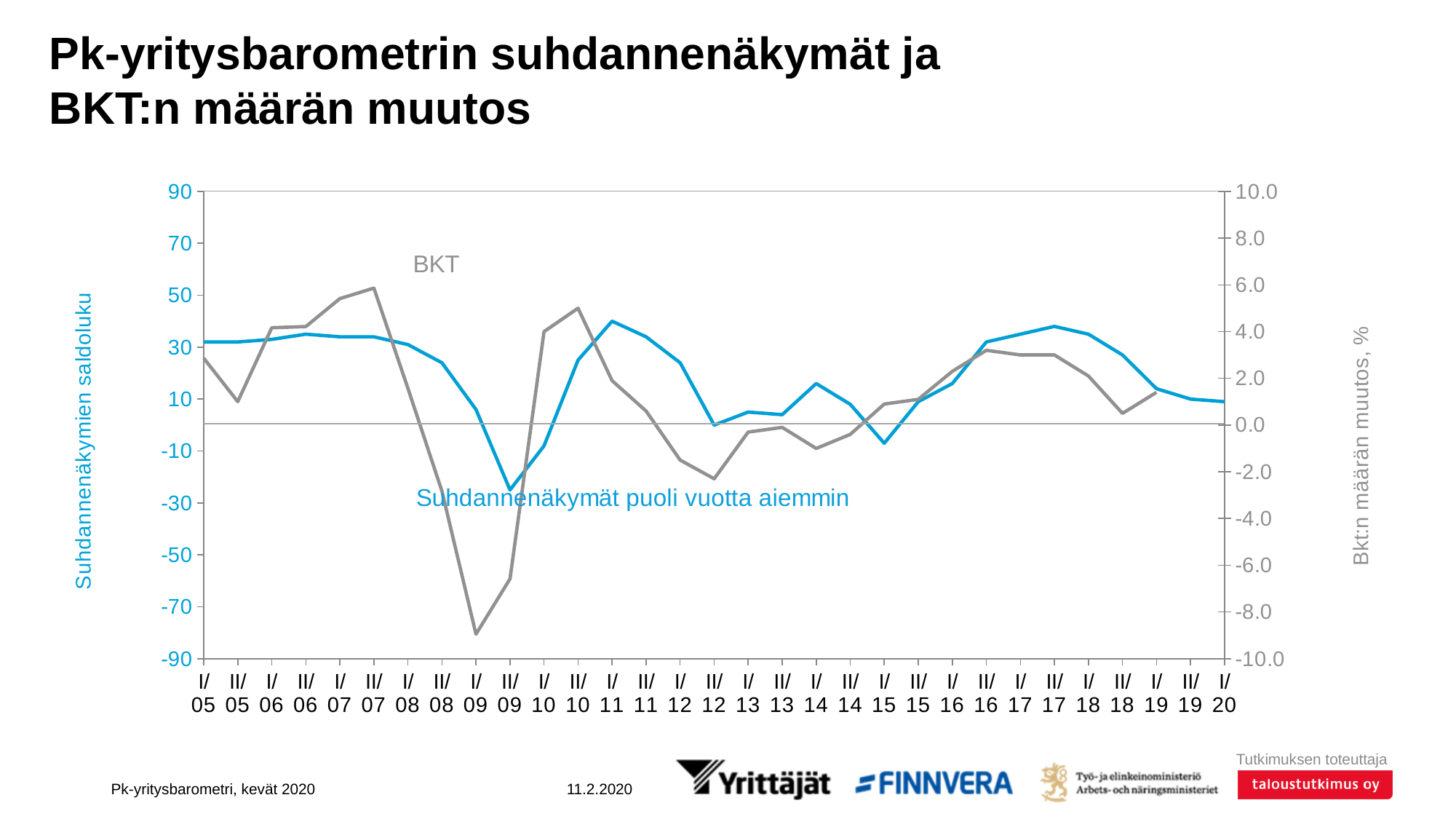
What is the title of the left vertical axis? Suhdannenäkymien saldoluku What kind of chart is shown on the slide? line chart How many series are plotted in the chart? 2 How many time points are labelled on the x axis of the chart? 31 Does the Suhdannenäkymät puoli vuotta aiemmin line rise or fall from II/17 to I/20? fall Is the BKT value at I/09 greater or less than -8.0? less Which is larger for the BKT line: the value at I/09 or the value at II/09? II/09 Is the BKT value at II/07 greater or less than 4.0? greater At which time point does the BKT line reach its lowest value? I/09 At which time point does the Suhdannenäkymät puoli vuotta aiemmin line reach its lowest value? II/09 At which time point does the BKT line reach its highest value? II/07 Is the Suhdannenäkymät puoli vuotta aiemmin value at I/11 greater or less than 30? greater